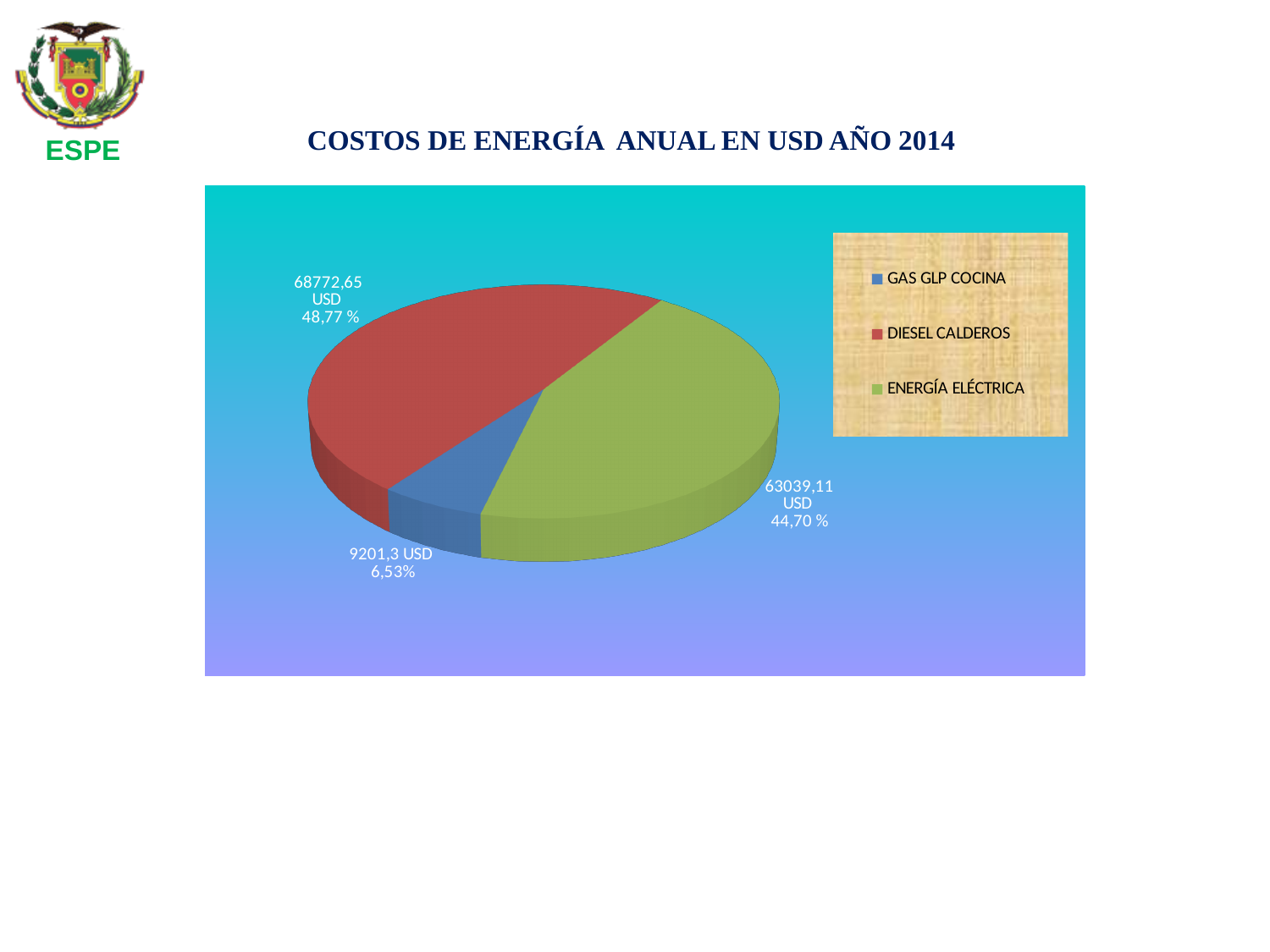
What is the difference in USD between the DIESEL CALDEROS cost and the ENERGÍA ELÉCTRICA cost? 5733,54 USD Which category has the lowest annual cost? GAS GLP COCINA What is the annual cost for DIESEL CALDEROS? 68772,65 USD What type of chart is shown on the slide? Pie chart What share of the pie does GAS GLP COCINA represent? 6,53% What is the annual cost for ENERGÍA ELÉCTRICA? 63039,11 USD Which category has the highest annual cost? DIESEL CALDEROS Which is larger, the cost for ENERGÍA ELÉCTRICA or the cost for GAS GLP COCINA? ENERGÍA ELÉCTRICA What is the annual cost for GAS GLP COCINA? 9201,3 USD How many categories does the pie chart show? 3 What share of the pie does DIESEL CALDEROS represent? 48,77 % What share of the pie does ENERGÍA ELÉCTRICA represent? 44,70 %